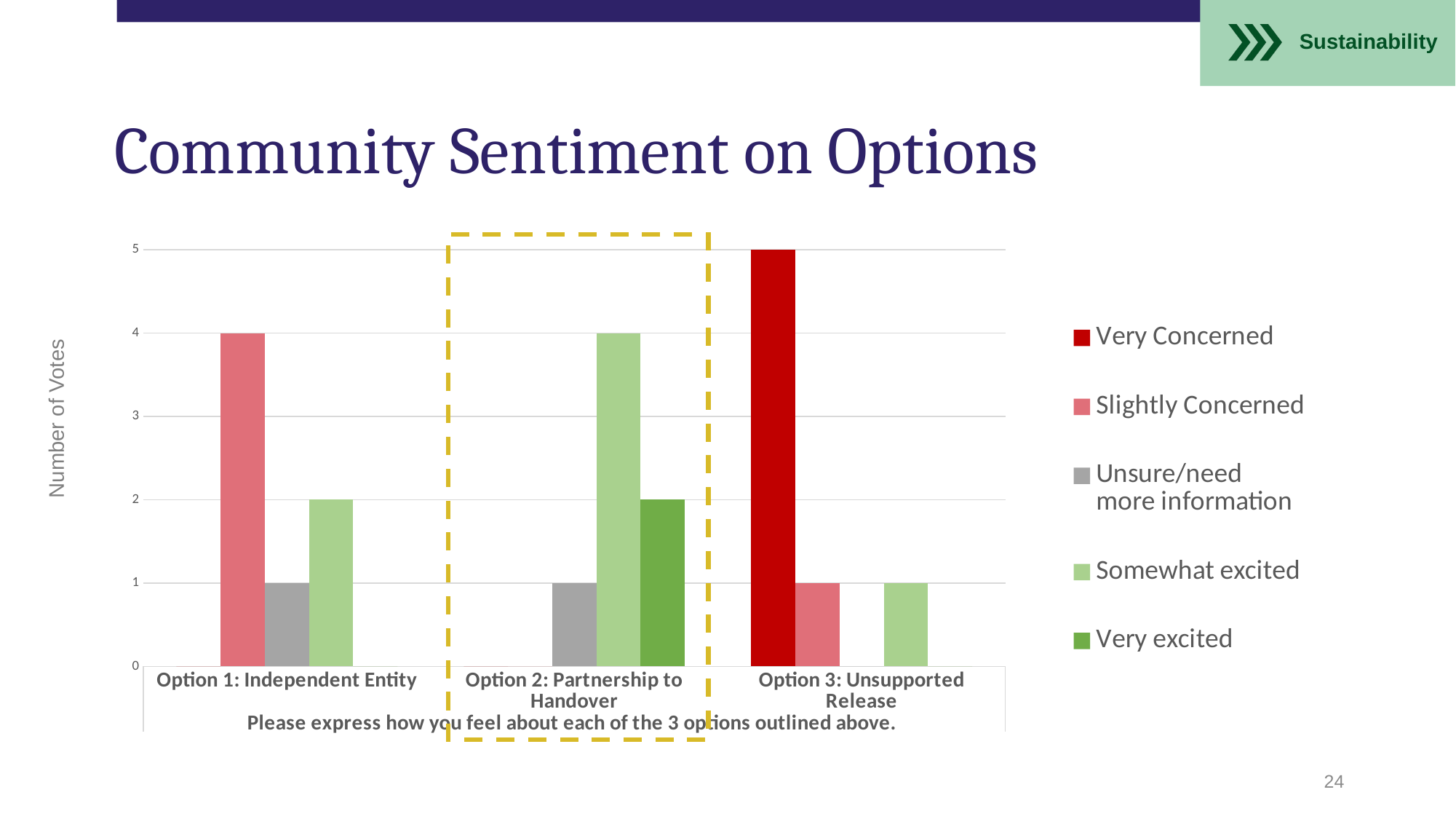
Which is larger: the Slightly Concerned votes for Option 1 or for Option 3? Option 1 How many votes did Option 1: Independent Entity receive for Slightly Concerned? 4 How many votes did Option 2: Partnership to Handover receive for Very excited? 2 Which option received the most Very Concerned votes? Option 3: Unsupported Release How many votes did Option 2: Partnership to Handover receive for Somewhat excited? 4 How many votes did Option 3: Unsupported Release receive for Very Concerned? 5 How many series does the legend list? 5 What kind of chart is shown on the slide? bar chart Which option received the most Somewhat excited votes? Option 2: Partnership to Handover What is the difference between the Somewhat excited votes for Option 2 and for Option 1? 2 How many options (categories) are shown on the x axis? 3 What is the label on the vertical axis? Number of Votes